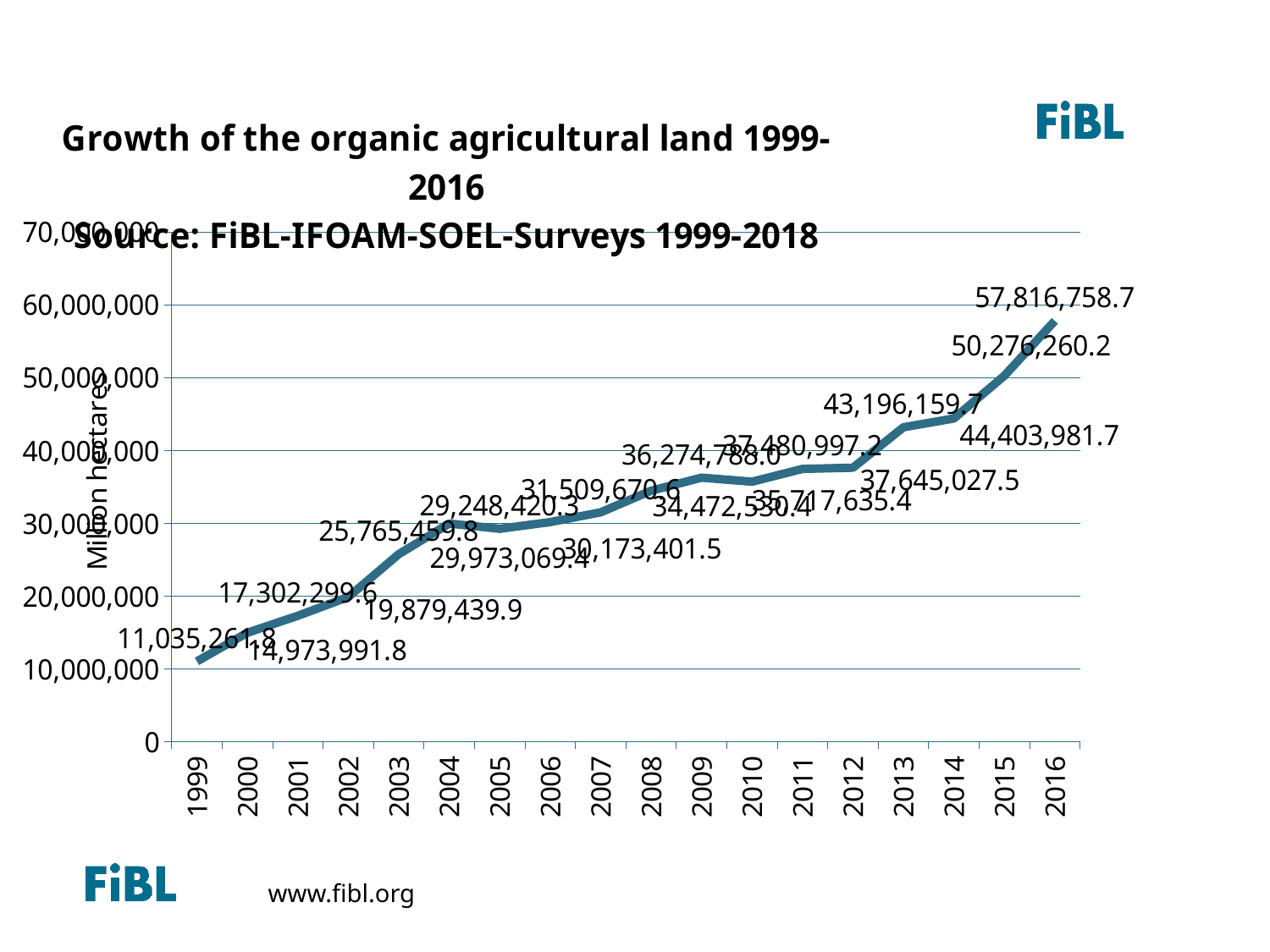
What is the difference between the values for 2016 and 2015? 7,540,498.5 What is the value for 2015? 50,276,260.2 What is the label on the y axis? Million hectares Which year has the highest value? 2016 Which year has the lowest value? 1999 What kind of chart is shown on the slide? line chart How many years are plotted on the x axis? 18 What is the value for 1999? 11,035,261.8 Do the values generally rise or fall from 1999 to 2016? rise Is the value for 2010 greater or less than 30,000,000? greater What is the value for 2016? 57,816,758.7 What is the value for 2003? 25,765,459.8